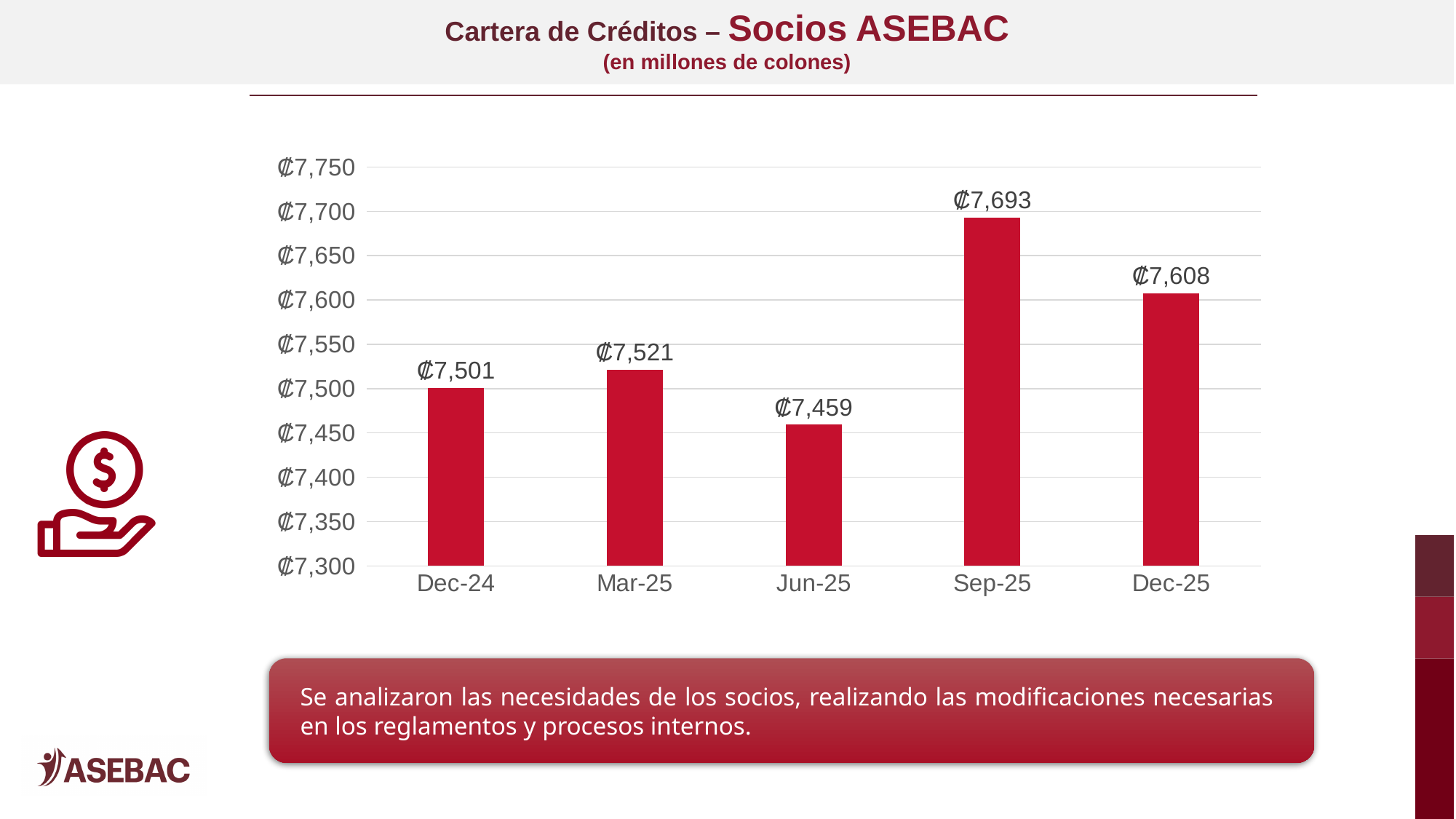
What is the value for Jun-25? ₡7,459 What is the difference between the Mar-25 and Dec-24 values? ₡20 What unit is stated in the chart's subtitle? en millones de colones How many periods are shown on the x axis? 5 Is the value for Dec-25 greater or less than ₡7,600? greater Which period has the highest value? Sep-25 What is the value for Dec-24? ₡7,501 What kind of chart is shown on the slide? Bar chart What is the value for Sep-25? ₡7,693 Which is larger, the value for Mar-25 or the value for Jun-25? Mar-25 What is the difference between the Sep-25 and Dec-25 values? ₡85 Which period has the lowest value? Jun-25